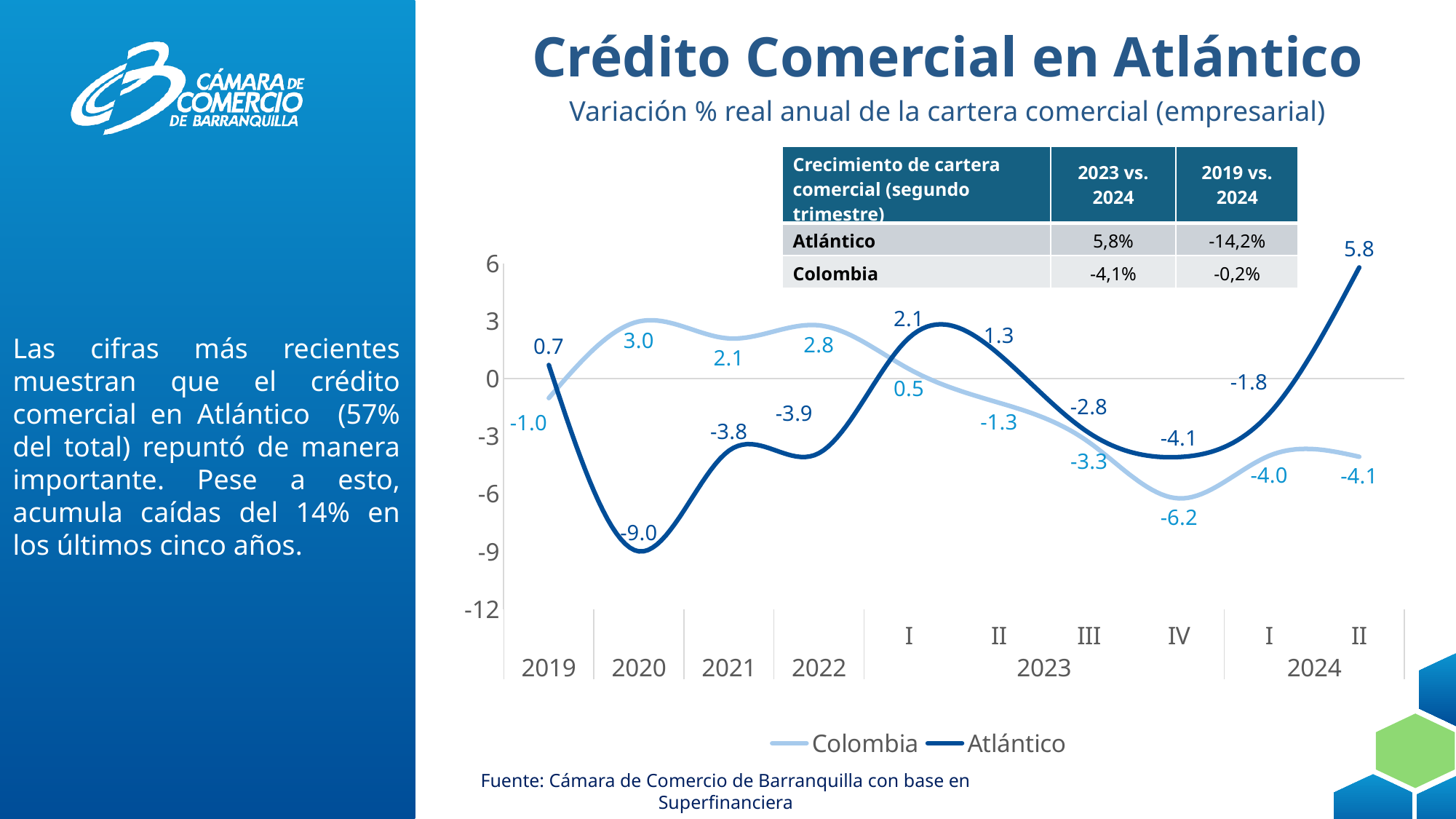
What is the difference between the Atlántico value in II 2024 (5.8) and the Colombia value in II 2024 (-4.1)? 9.9 Does the Atlántico series rise or fall between IV 2023 and II 2024? rise What is the value for Colombia in the second quarter (II) of 2024? -4.1 Which series has the larger value in 2021, Colombia or Atlántico? Colombia How many series does the chart legend list? 2 At which point does the Atlántico series reach its highest value? II 2024 What is the value for Atlántico in 2020? -9.0 What is the value for Atlántico in the fourth quarter (IV) of 2023? -4.1 At which point does the Colombia series reach its lowest value? IV 2023 What type of chart is shown on the slide? line chart Which series is drawn with the darker blue line? Atlántico How many data points are plotted for each series along the x axis? 10